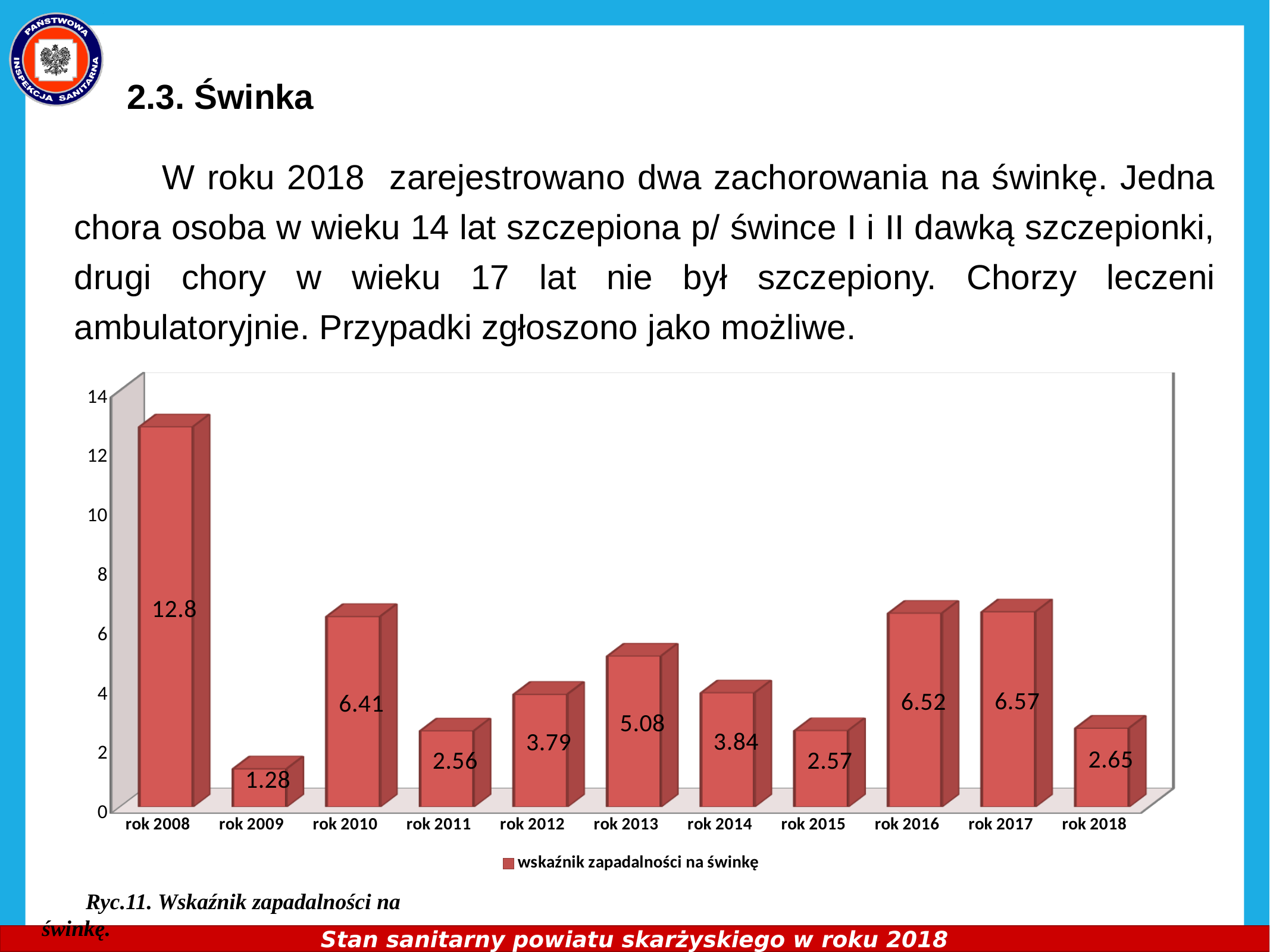
What is the legend entry of the chart? wskaźnik zapadalności na świnkę What is the difference between the values for rok 2008 and rok 2009? 11.52 Is the value for rok 2016 greater or less than 6? greater What is the value for rok 2008? 12.8 What kind of chart is shown? bar chart Which year has the lowest value? rok 2009 What is the value for rok 2018? 2.65 Which year has the highest value? rok 2008 Which is larger, the value for rok 2010 or the value for rok 2013? rok 2010 What is the value for rok 2013? 5.08 How many years are shown on the x axis? 11 How many series does the legend list? 1